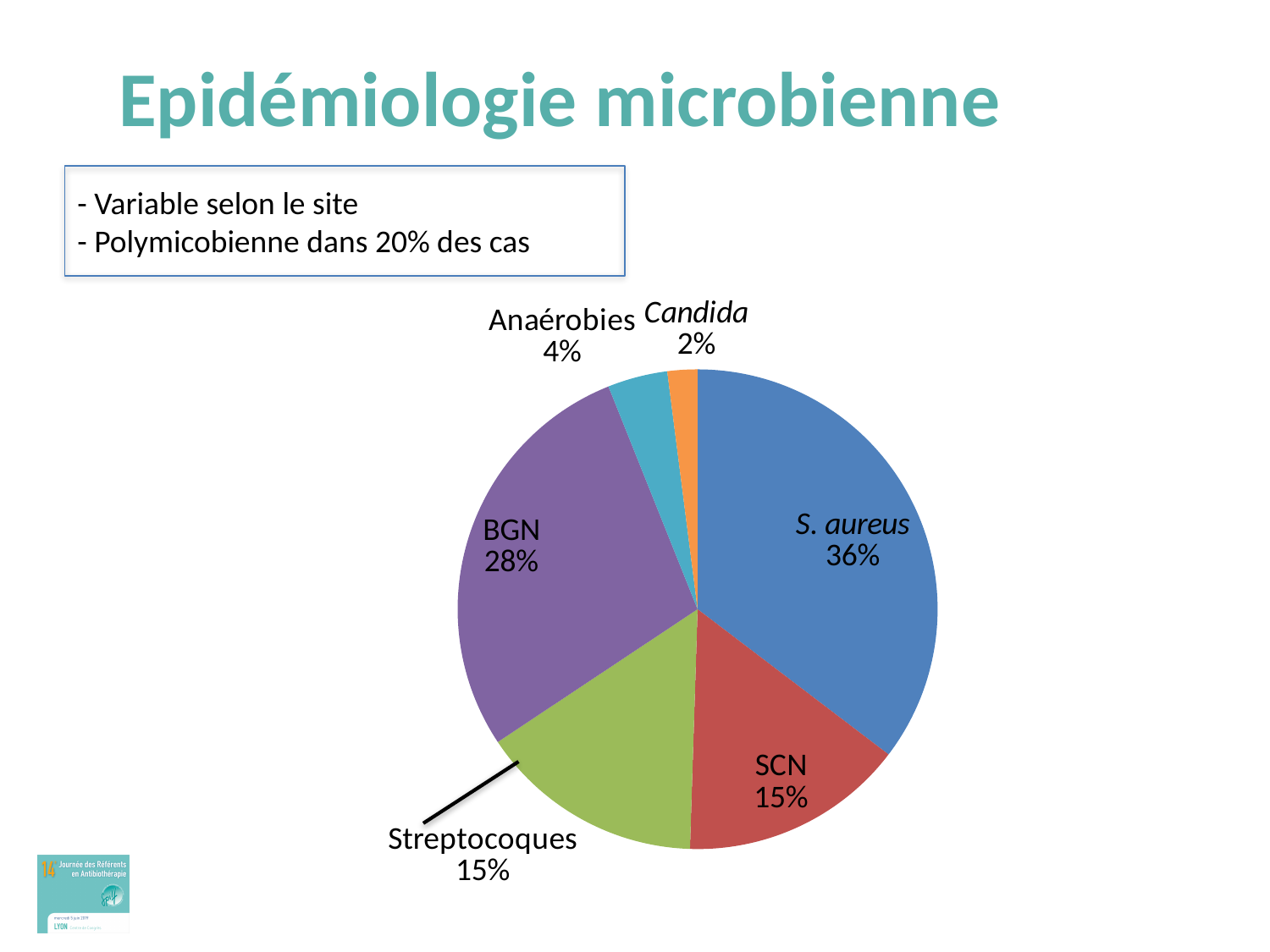
What is the difference between the S. aureus share and the BGN share? 8% Which is larger, the share for BGN or the share for SCN? BGN Which category has the largest slice of the pie? S. aureus What is the value shown for BGN? 28% What is the combined share of SCN and Streptocoques? 30% Which category has the smallest slice of the pie? Candida How many slices does the pie chart have? 6 What kind of chart is shown on the slide? pie chart What share of the pie does S. aureus represent? 36% What colour is the S. aureus slice? blue What is the value for Anaérobies? 4% What percentage is shown for Candida? 2%